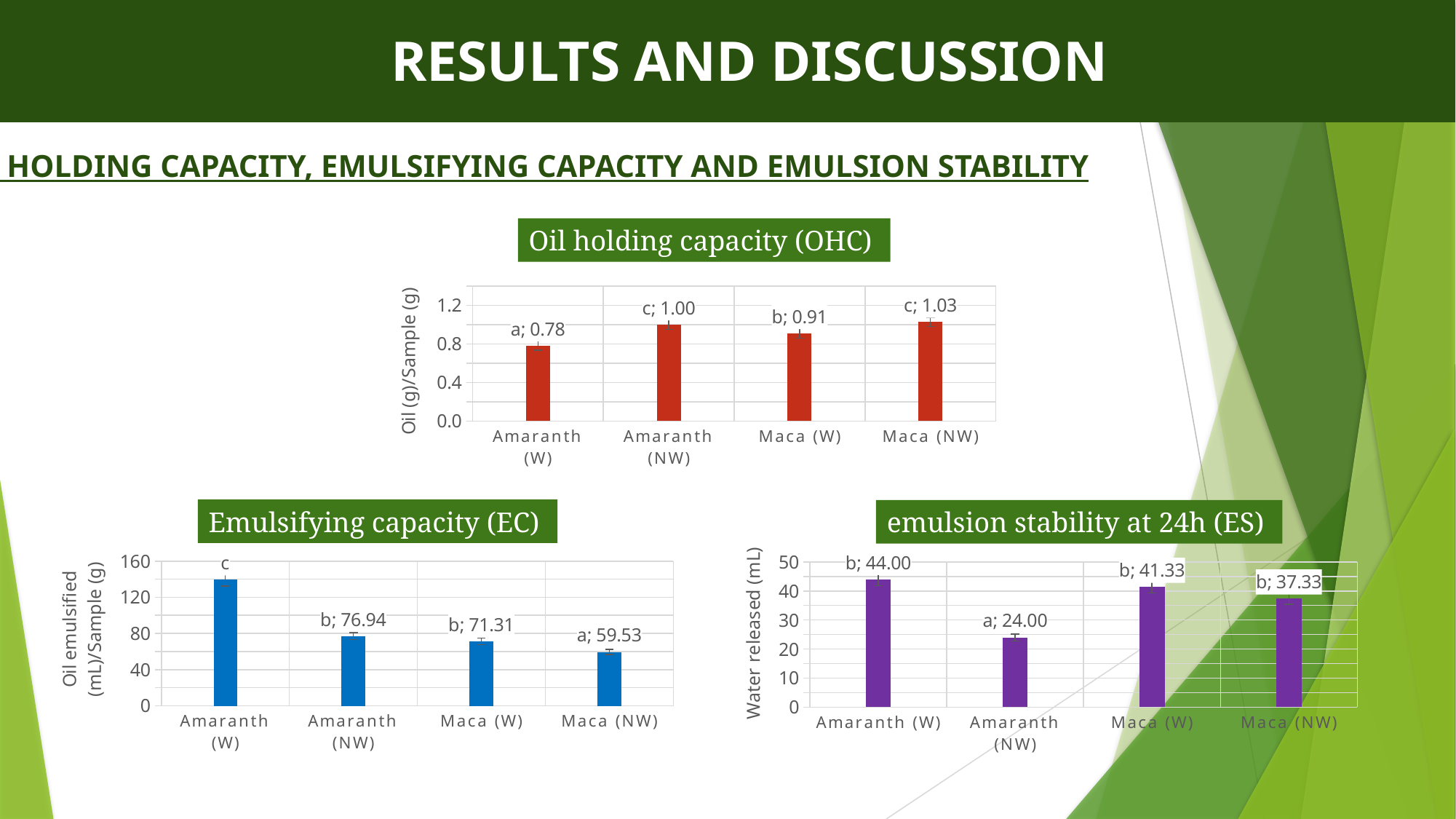
In the emulsion stability at 24h (ES) chart, what is the difference between Maca (W) and Maca (NW)? 4.00 In the Oil holding capacity (OHC) chart, what is the value for Maca (NW)? 1.03 In the Emulsifying capacity (EC) chart, is the value for Amaranth (W) greater or less than 120? greater In the emulsion stability at 24h (ES) chart, which category has the highest value? Amaranth (W) In the Emulsifying capacity (EC) chart, what is the value for Maca (W)? 71.31 In the Oil holding capacity (OHC) chart, which category has the lowest value? Amaranth (W) What type of chart is the Emulsifying capacity (EC) chart? Bar chart In the emulsion stability at 24h (ES) chart, what is the value for Amaranth (NW)? 24.00 In the emulsion stability at 24h (ES) chart, which is larger, Amaranth (W) or Maca (W)? Amaranth (W) How many categories are shown in the Oil holding capacity (OHC) chart? 4 In the Oil holding capacity (OHC) chart, what is the difference between Amaranth (NW) and Amaranth (W)? 0.22 In the Emulsifying capacity (EC) chart, which category has the lowest value? Maca (NW)